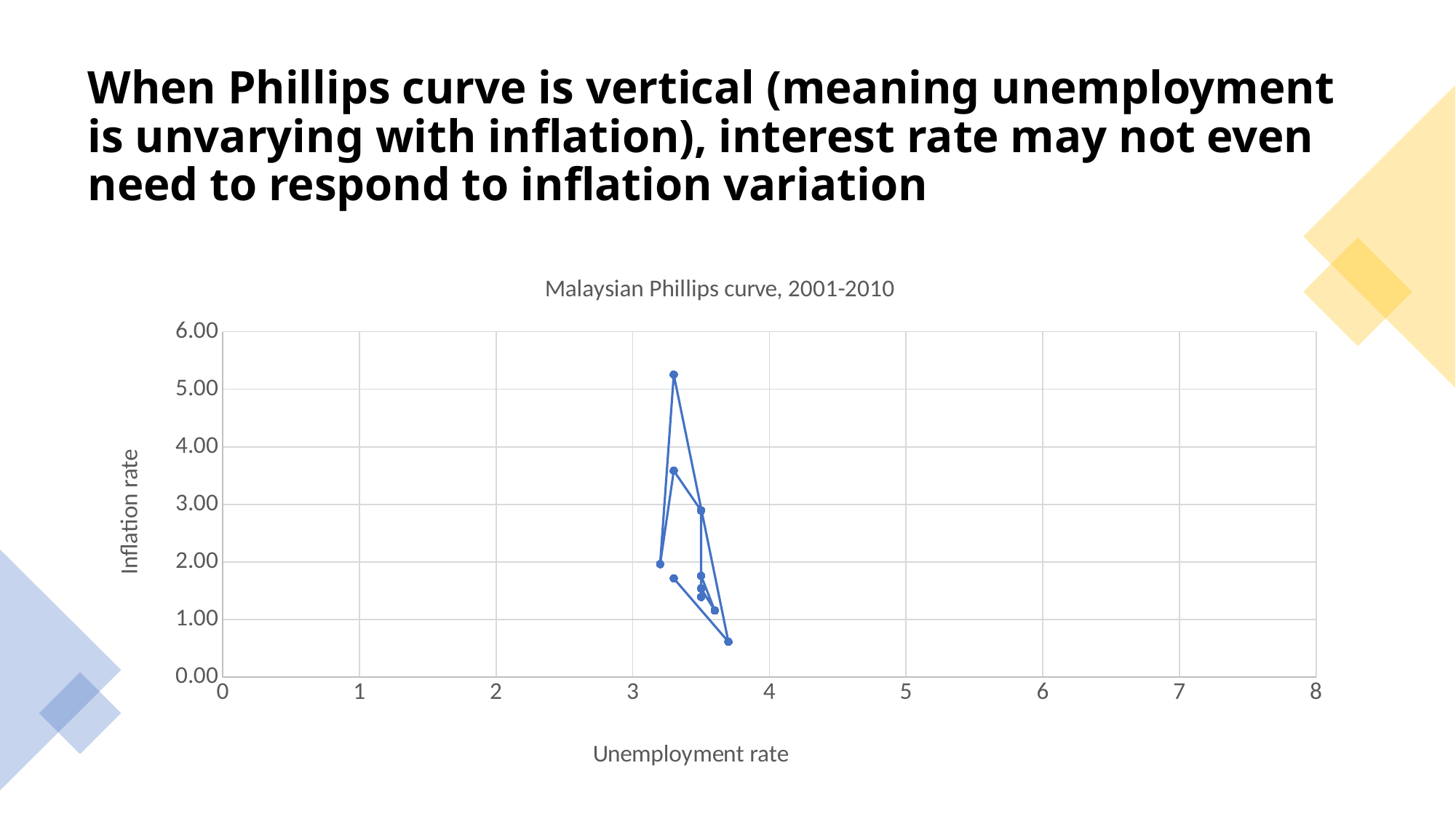
Do all the plotted points have an unemployment rate between 3 and 4? Yes Is the unemployment rate of the point with the lowest inflation rate greater or less than 4? less Is the lowest inflation rate plotted on the chart greater or less than 1.00? less What kind of chart is shown on the slide? Scatter chart with connected points What is the label of the horizontal axis of the chart? Unemployment rate How many data points are plotted on the chart? 10 What is the title of the chart? Malaysian Phillips curve, 2001-2010